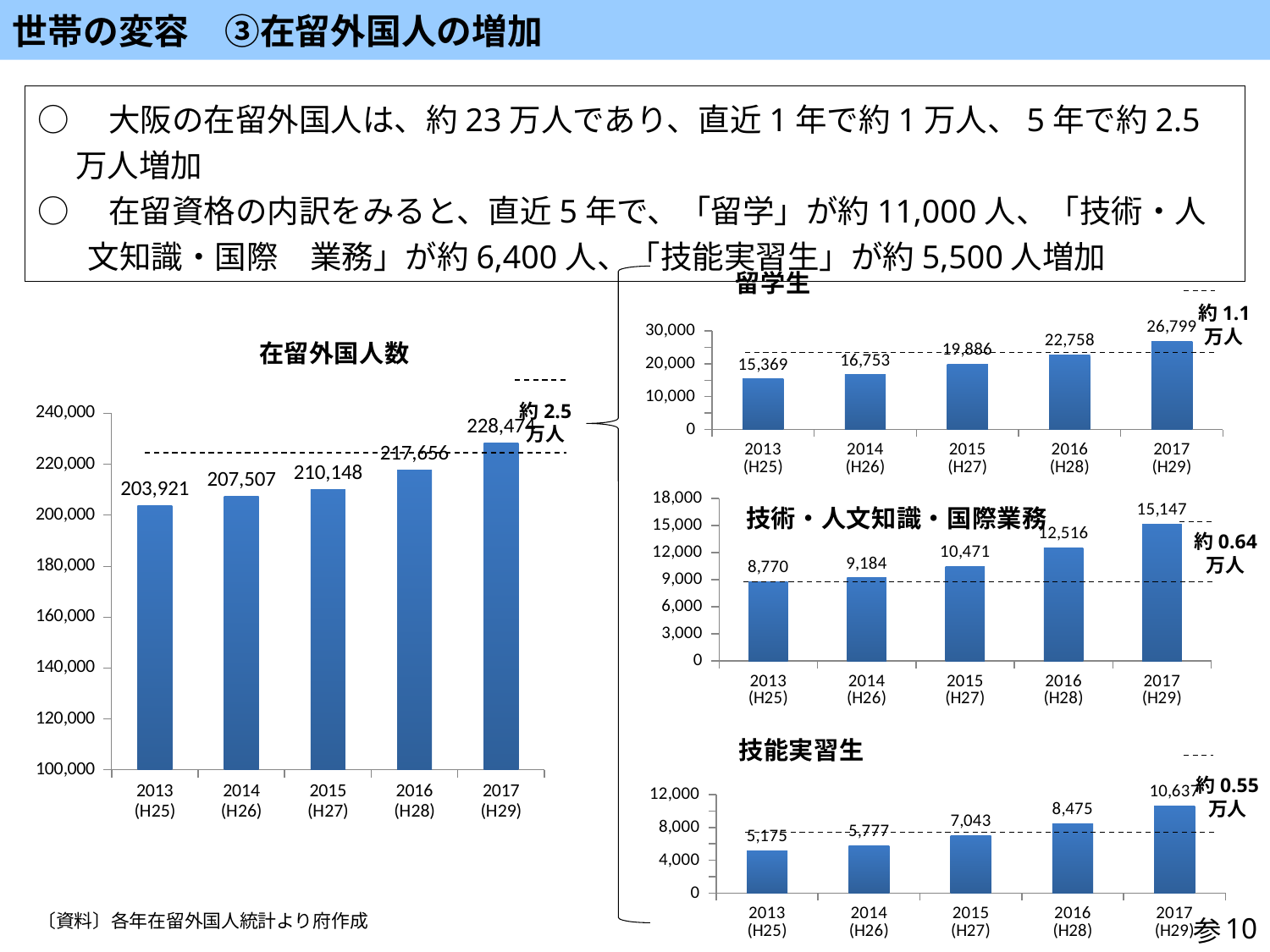
In the 留学生 chart, what is the value for 2017 (H29)? 26,799 How many years are plotted in the 技術・人文知識・国際業務 chart? 5 In the 技術・人文知識・国際業務 chart, which year has the highest value? 2017 (H29) In the 留学生 chart, what is the value for 2013 (H25)? 15,369 In the 在留外国人数 chart, what is the value for 2014 (H26)? 207,507 What kind of chart is the 留学生 chart? bar chart In the 技術・人文知識・国際業務 chart, what is the value for 2016 (H28)? 12,516 In the 在留外国人数 chart, is the value for 2017 (H29) greater or less than 220,000? greater In the 技能実習生 chart, which is larger, the value for 2014 (H26) or 2016 (H28)? 2016 (H28) In the 在留外国人数 chart, which year has the lowest value? 2013 (H25) In the 留学生 chart, what is the difference between the 2017 (H29) and 2013 (H25) values? 11,430 In the 技能実習生 chart, what is the value for 2015 (H27)? 7,043